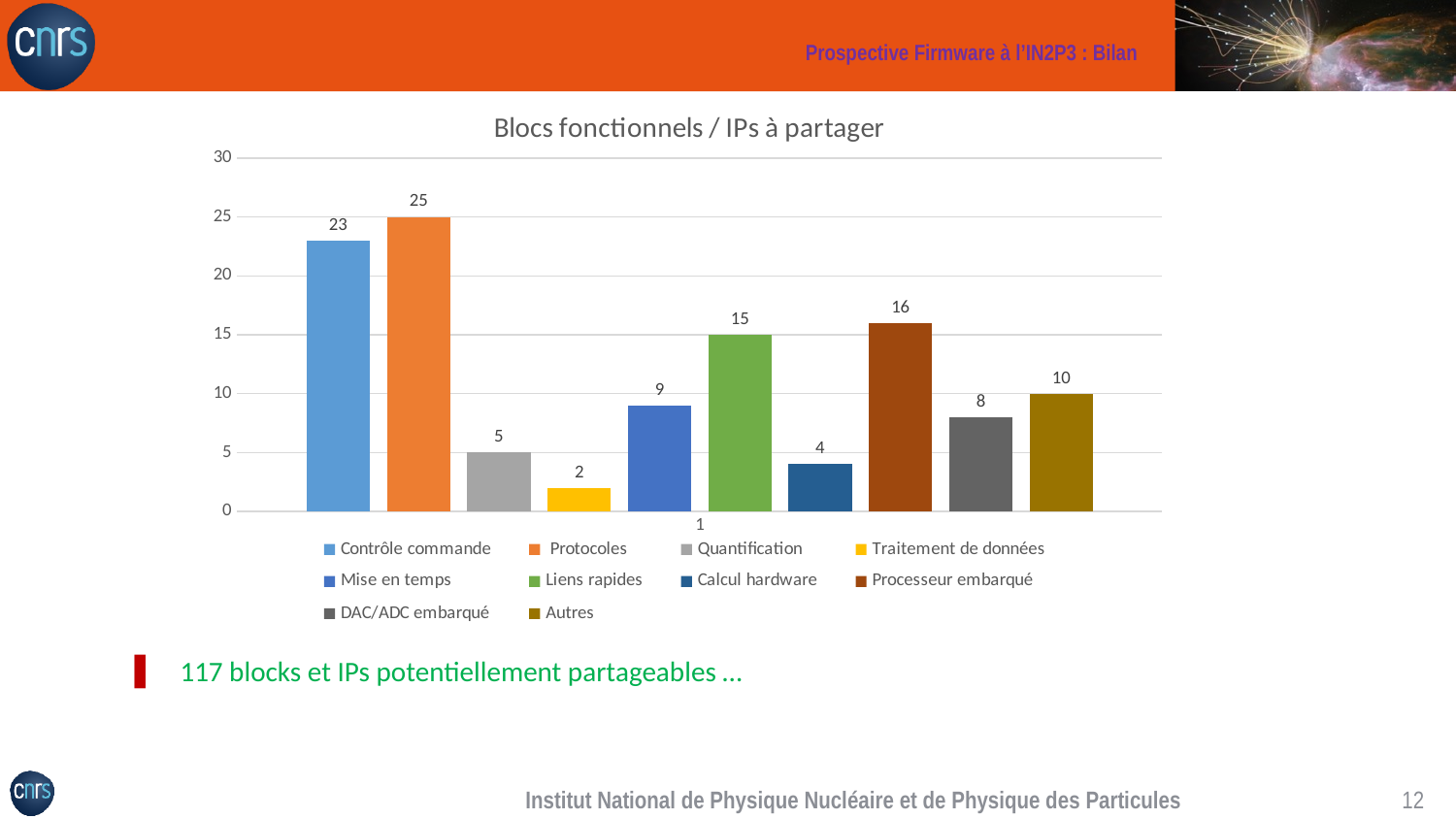
What is the difference between the values for Processeur embarqué and DAC/ADC embarqué? 8 Which is larger, the value for Mise en temps or the value for Autres? Autres What is the value for Protocoles? 25 What is the value for Liens rapides? 15 What is the value for Traitement de données? 2 What is the title of the chart? Blocs fonctionnels / IPs à partager How many series does the legend list? 10 Which series has the highest value? Protocoles What is the value for Contrôle commande? 23 Which series has the lowest value? Traitement de données What kind of chart is shown on the slide? Bar chart What is the difference between the values for Protocoles and Contrôle commande? 2